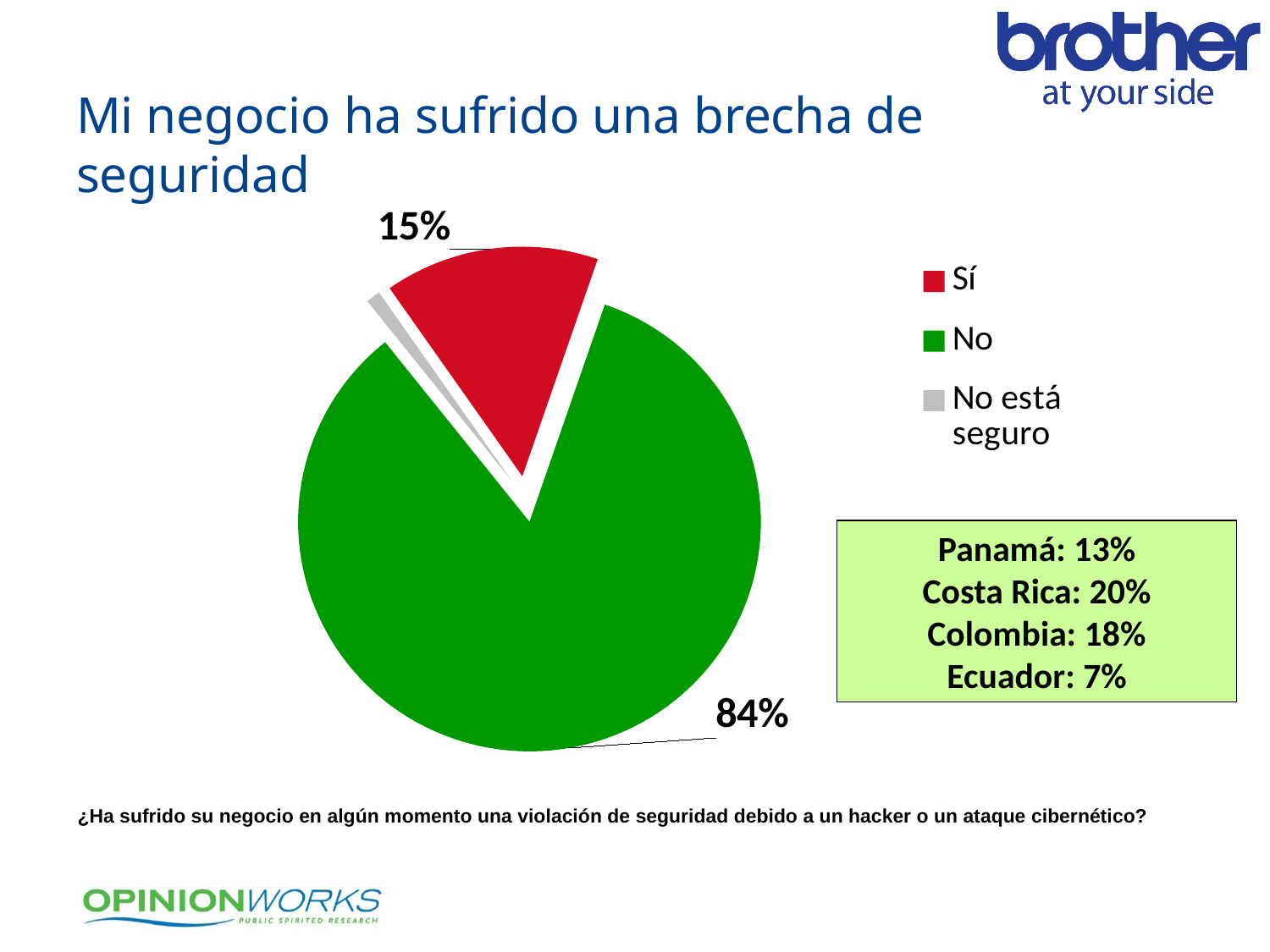
Which category has the largest slice of the pie? No What kind of chart is shown on the slide? pie chart What colour is the "Sí" slice in the pie chart? red What colour is the "No" slice in the pie chart? green Which category has the smallest slice of the pie? No está seguro What is the difference in percentage points between the "No" slice and the "Sí" slice? 69 What share of the pie does the "Sí" slice represent? 15% What percentage of the pie is labelled for the "Sí" slice? 15% How many categories does the pie chart have? 3 How many entries does the legend list? 3 What percentage of the pie is labelled for the "No" slice? 84% Which slice is larger, "Sí" or "No"? No